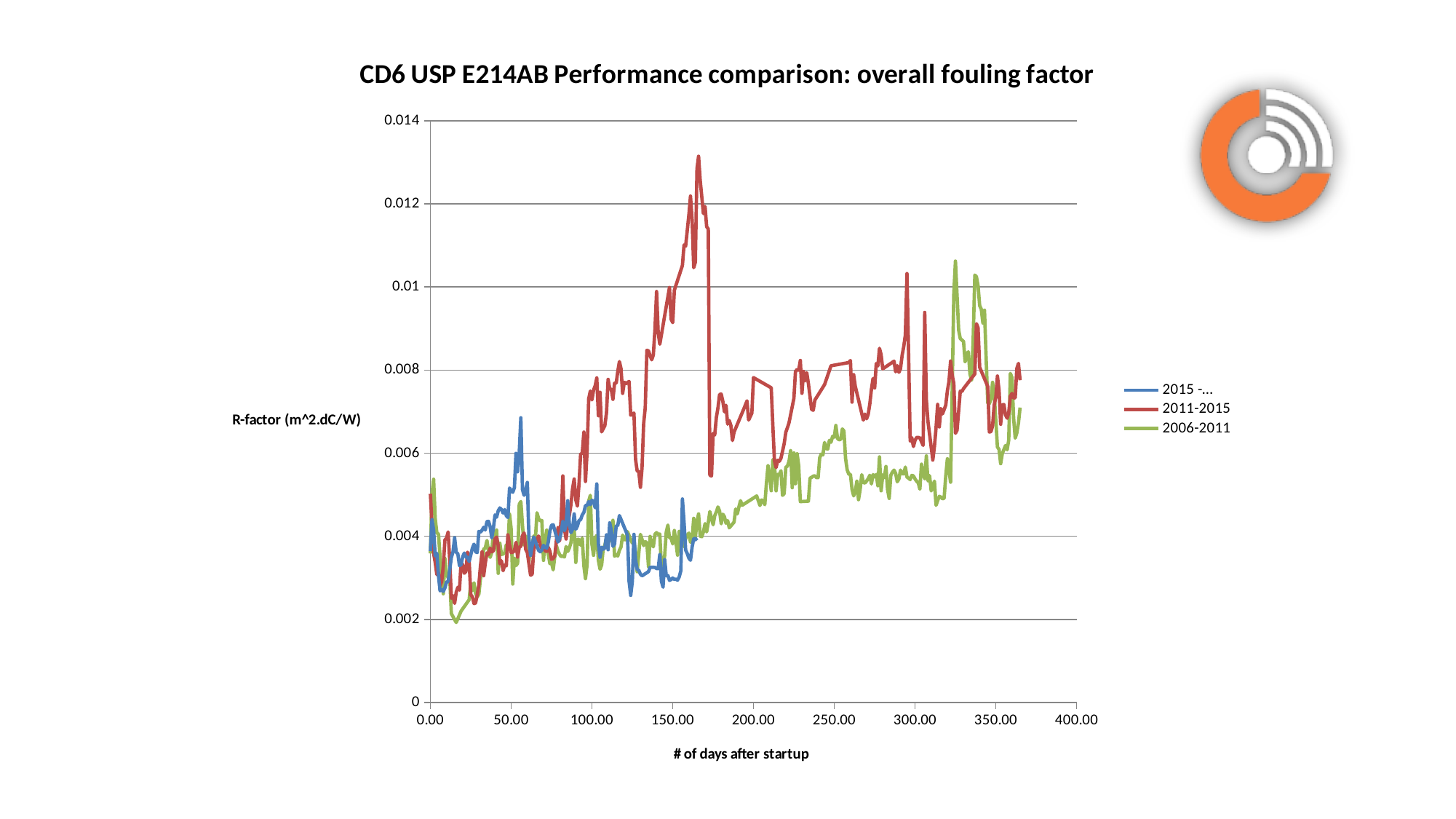
Which series stops earliest along the x axis? 2015 - What is the label of the x axis? # of days after startup Is the lowest value of the 2006-2011 series greater or less than 0.004? less What is the title of the chart? CD6 USP E214AB Performance comparison: overall fouling factor Is the peak value of the 2011-2015 series greater or less than 0.012? greater Which series reaches the highest R-factor value on the chart? 2011-2015 How many series does the legend list? 3 What kind of chart is shown on the slide? Line chart Is the value of the 2011-2015 series at 200 days after startup greater or less than 0.006? greater Does the 2011-2015 series generally rise or fall between 0 and 150 days after startup? rise